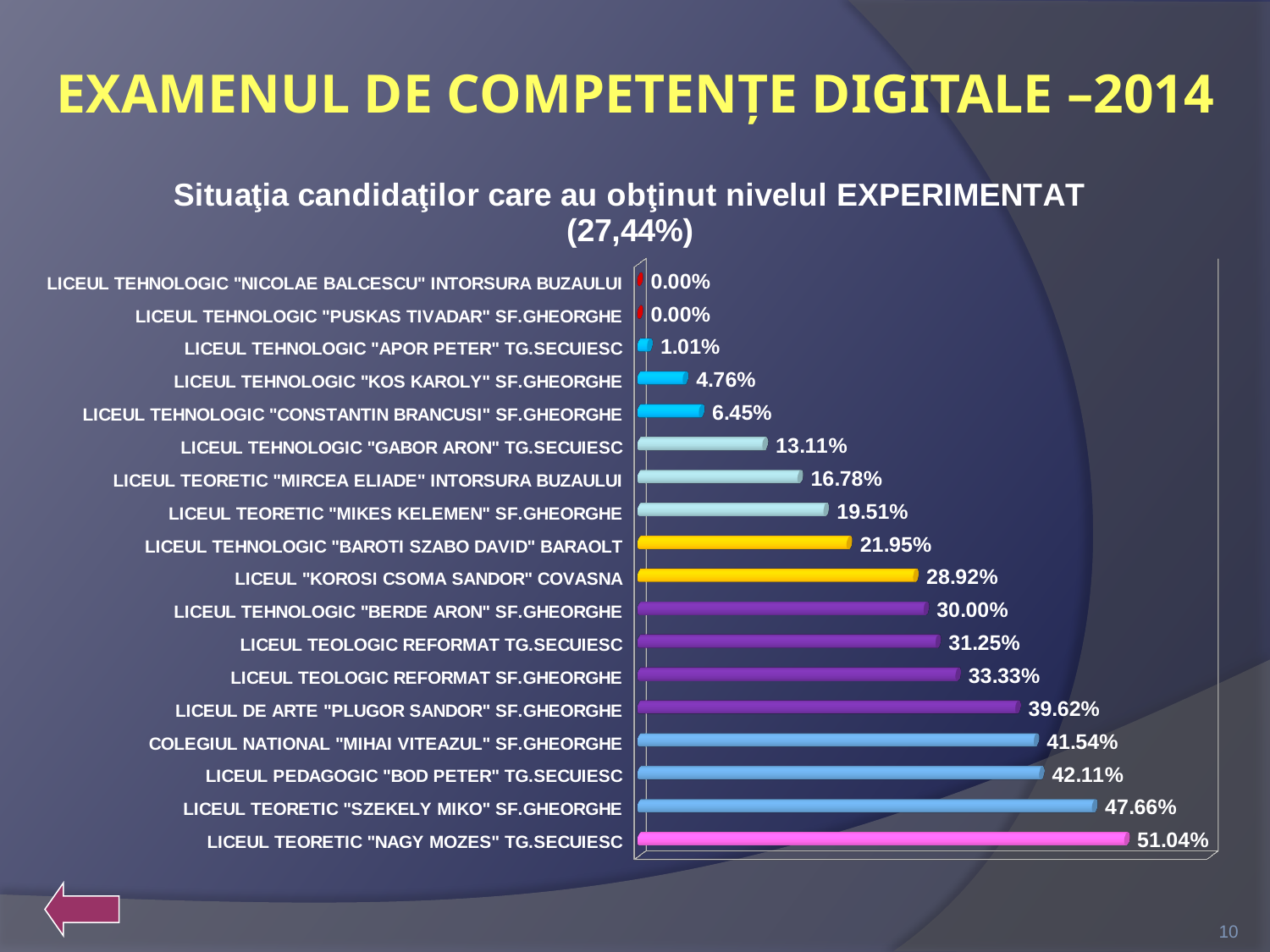
What is the difference between the values for LICEUL TEORETIC "NAGY MOZES" TG.SECUIESC and LICEUL TEORETIC "SZEKELY MIKO" SF.GHEORGHE? 3.38% What is the value for COLEGIUL NATIONAL "MIHAI VITEAZUL" SF.GHEORGHE? 41.54% How many schools are listed in the chart? 18 What is the value for LICEUL TEHNOLOGIC "GABOR ARON" TG.SECUIESC? 13.11% Which has a larger value: LICEUL PEDAGOGIC "BOD PETER" TG.SECUIESC or LICEUL DE ARTE "PLUGOR SANDOR" SF.GHEORGHE? LICEUL PEDAGOGIC "BOD PETER" TG.SECUIESC What is the value for LICEUL TEORETIC "NAGY MOZES" TG.SECUIESC? 51.04% What kind of chart is shown on the slide? bar chart Do the values increase or decrease going from the top of the chart to the bottom? increase What is the value for LICEUL TEHNOLOGIC "APOR PETER" TG.SECUIESC? 1.01% What is the difference between the values for LICEUL TEOLOGIC REFORMAT SF.GHEORGHE and LICEUL TEOLOGIC REFORMAT TG.SECUIESC? 2.08% What overall percentage is given in parentheses in the chart title? 27,44% Which school has the highest value in the chart? LICEUL TEORETIC "NAGY MOZES" TG.SECUIESC